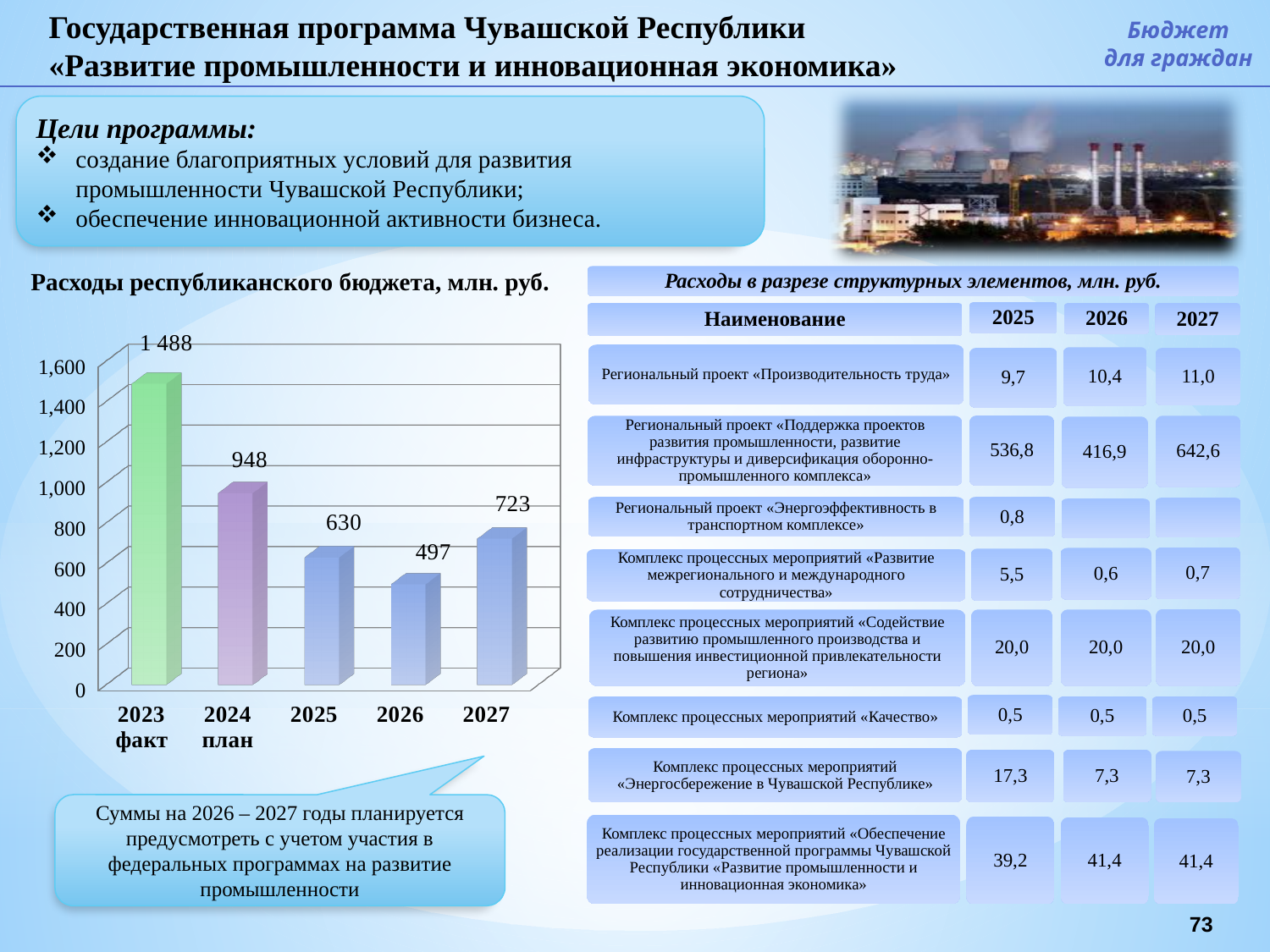
Which year has the highest value in the chart? 2023 факт What is the value for 2023 факт in the chart 'Расходы республиканского бюджета, млн. руб.'? 1 488 Which is larger, the value for 2025 or the value for 2027? 2027 What kind of chart is shown on the slide? bar chart What is the difference between the values for 2027 and 2026? 226 What is the value for 2025 in the chart? 630 What is the value for 2024 план in the chart? 948 What is the value for 2027 in the chart? 723 How many bars are shown in the chart? 5 What is the difference between the values for 2023 факт and 2024 план? 540 Which year has the lowest value in the chart? 2026 What is the title of the chart on the slide? Расходы республиканского бюджета, млн. руб.